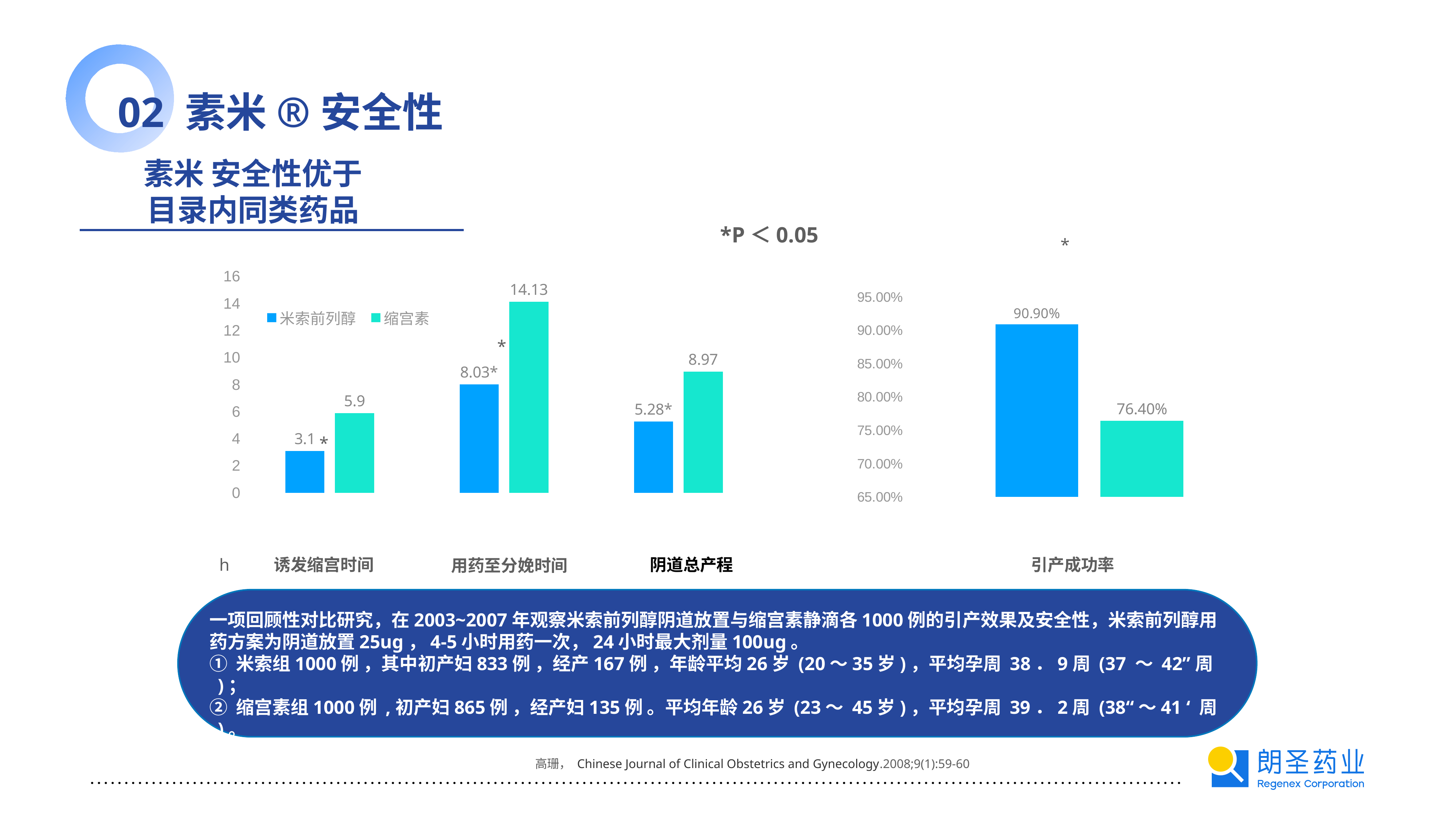
In the right chart (引产成功率), what is the value for 缩宫素? 76.40% In the left chart, what is the value for 缩宫素 in the 阴道总产程 category? 8.97 In the left chart, which series has the higher value for 用药至分娩时间, 米索前列醇 or 缩宫素? 缩宫素 In the right chart (引产成功率), what is the difference between the 米索前列醇 value and the 缩宫素 value? 14.50% In the left chart, what is the value for 缩宫素 in the 诱发缩宫时间 category? 5.9 How many series does the legend of the left chart list? 2 In the left chart, what is the value for 缩宫素 in the 用药至分娩时间 category? 14.13 What kind of chart is the right chart (引产成功率)? Bar chart In the left chart, what is the value for 米索前列醇 in the 诱发缩宫时间 category? 3.1 In the left chart, what is the difference between the 缩宫素 and 米索前列醇 values for 诱发缩宫时间? 2.8 In the left chart, which category has the highest 缩宫素 value? 用药至分娩时间 In the right chart (引产成功率), what is the value for 米索前列醇? 90.90%